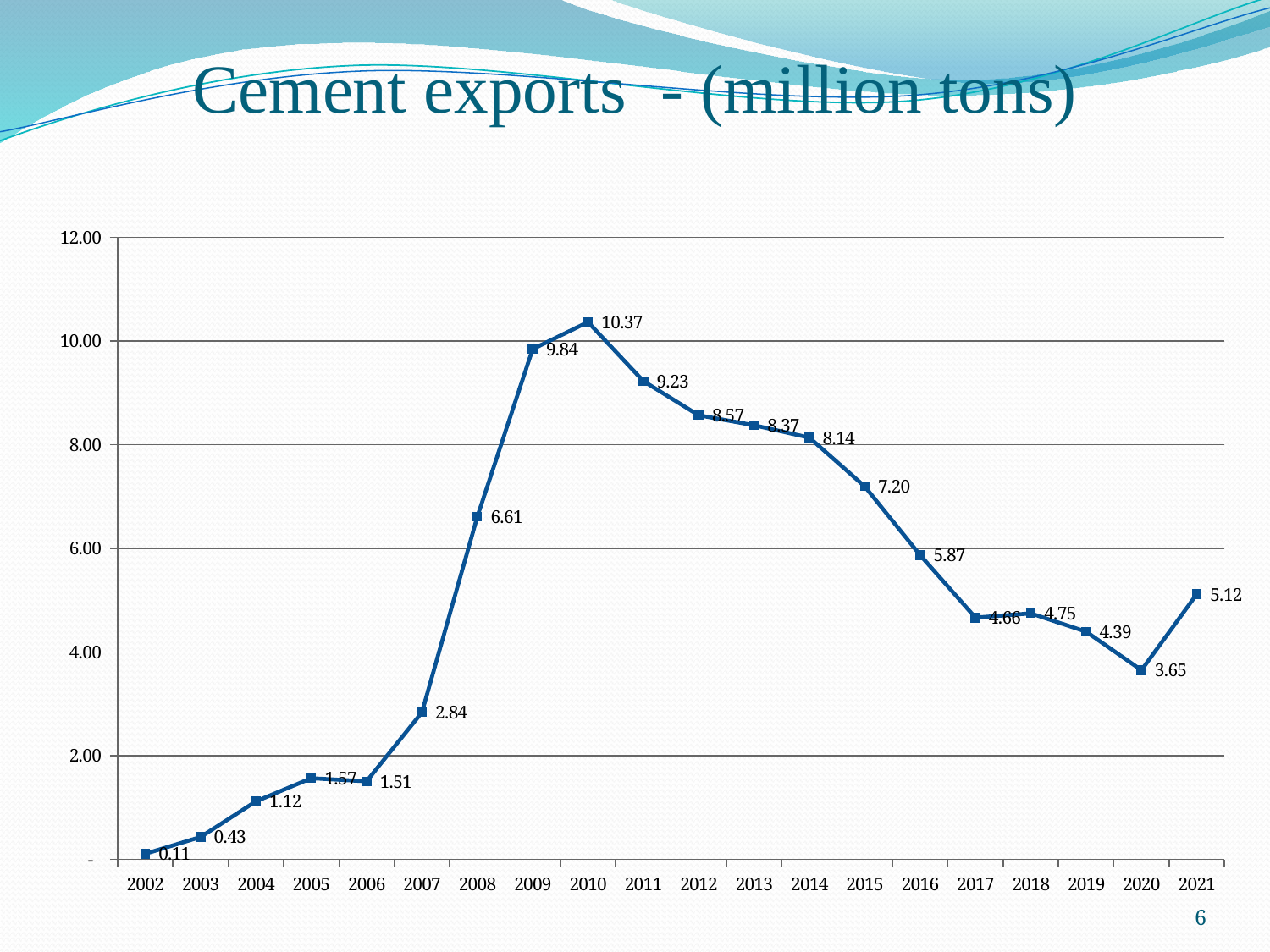
What was the value of cement exports in 2002? 0.11 Which year had the highest cement exports? 2010 Which year had higher cement exports, 2008 or 2016? 2008 What is the difference between cement exports in 2021 and 2020? 1.47 What was the value of cement exports in 2015? 7.20 What was the value of cement exports in 2010? 10.37 Which year had the lowest cement exports? 2002 Did cement exports rise or fall between 2010 and 2020? fall How many years are plotted on the x axis? 20 What was the value of cement exports in 2021? 5.12 What type of chart is shown on the slide? line chart What is the difference between cement exports in 2010 and 2009? 0.53